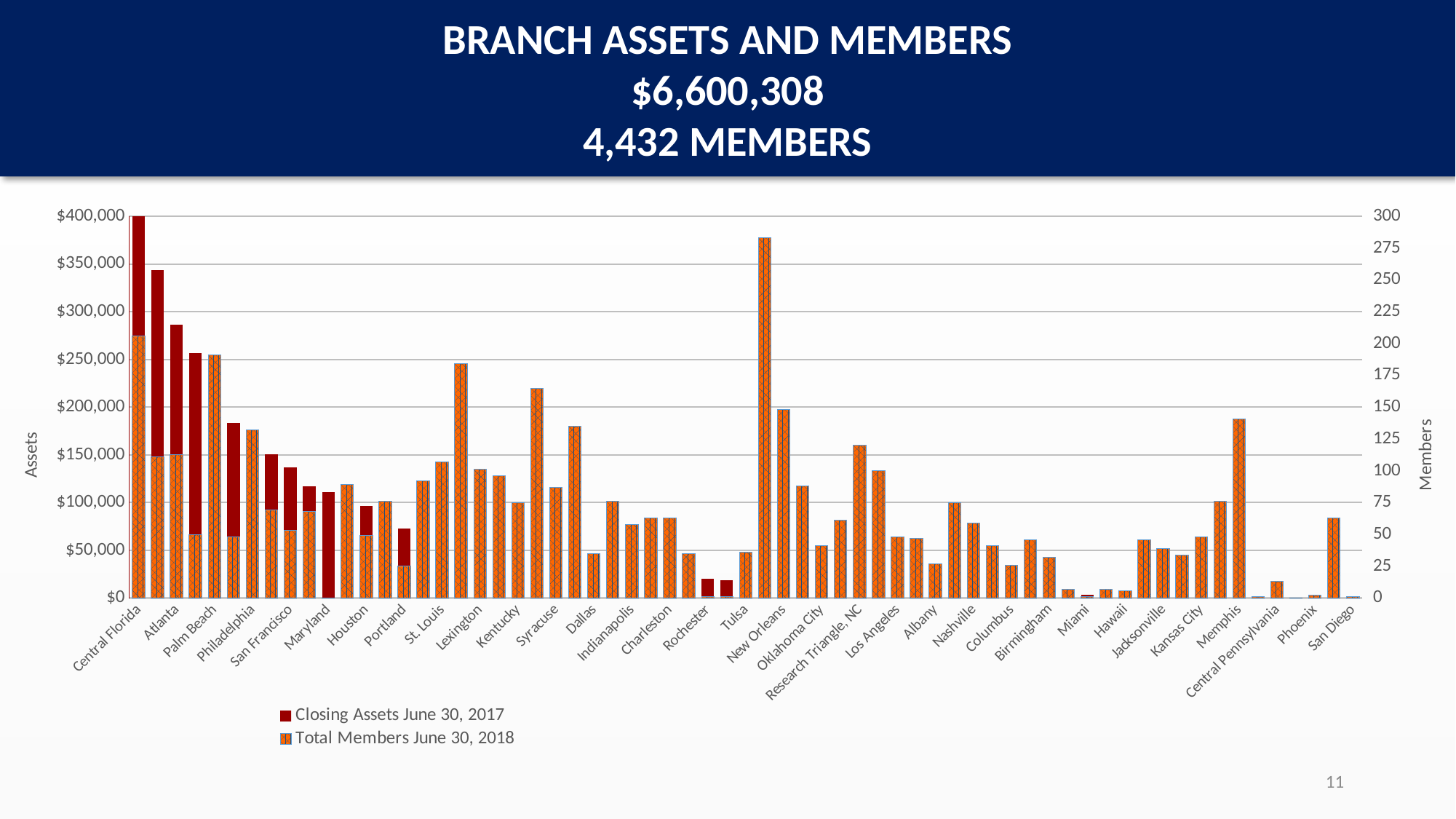
What is the title of the left vertical axis? Assets What kind of chart is shown on the slide? bar chart Do the Closing Assets June 30, 2017 values generally rise or fall from left to right along the x axis? fall Which branch has the highest Closing Assets June 30, 2017? Central Florida Is the Total Members June 30, 2018 value for New Orleans greater or less than 250? less How many series does the legend list? 2 Is the Total Members June 30, 2018 value for Central Florida greater or less than 150? greater What are the two series named in the legend? Closing Assets June 30, 2017; Total Members June 30, 2018 Which has higher Closing Assets June 30, 2017, Central Florida or Philadelphia? Central Florida According to the slide title, what is the total number of members? 4,432 Is the Closing Assets June 30, 2017 value for Central Florida greater or less than $350,000? greater